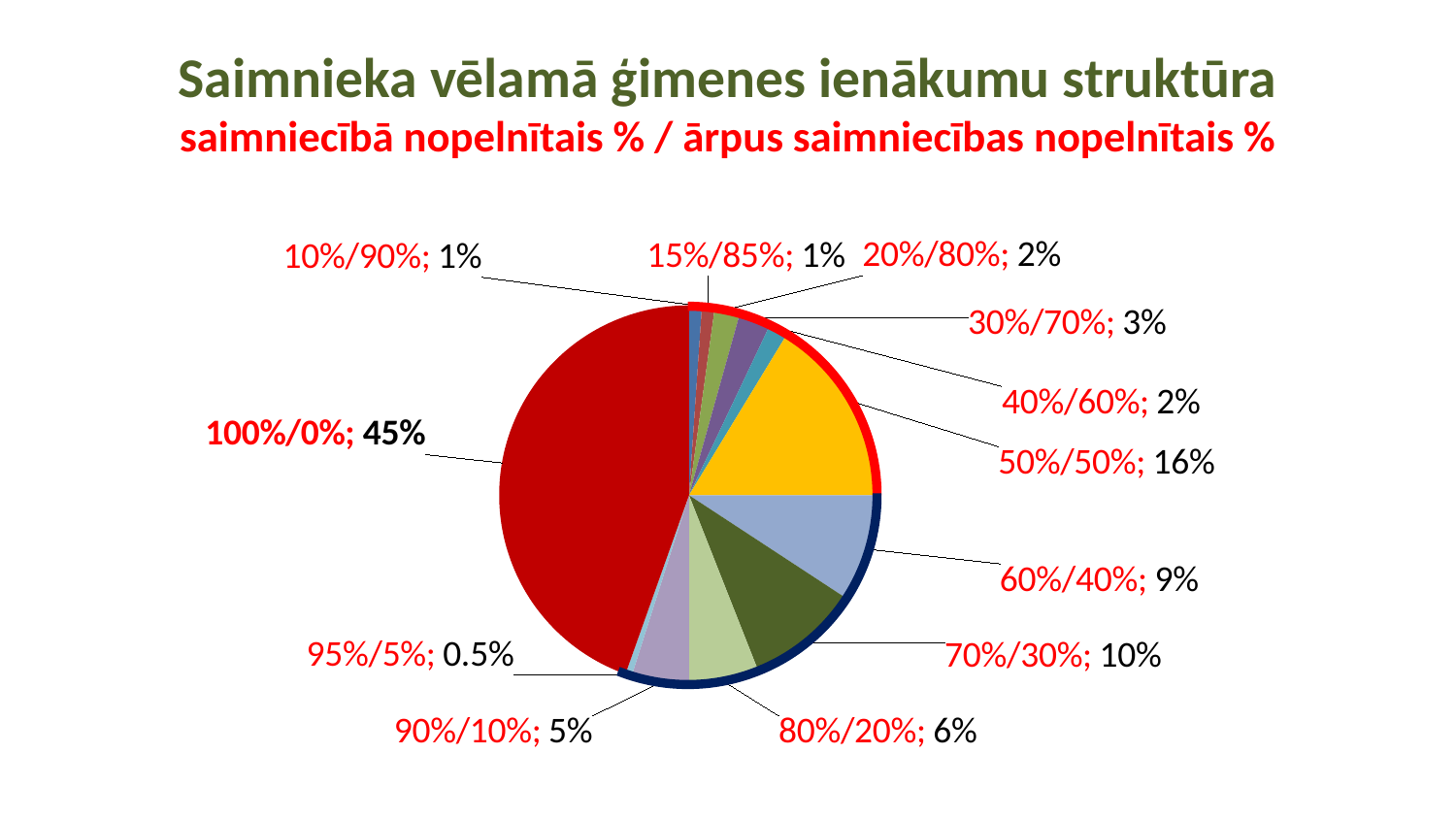
What is the value for the 70%/30% slice? 10% Which category has the smallest share of the pie? 95%/5% How many slices does the pie chart have? 12 What is the difference between the 50%/50% slice and the 60%/40% slice? 7% Which is larger, the 80%/20% slice or the 90%/10% slice? 80%/20% What is the value for the 95%/5% slice? 0.5% Which category has the largest share of the pie? 100%/0% What is the combined share of the 70%/30% and 80%/20% slices? 16% What is the value for the 50%/50% slice? 16% What type of chart is shown on the slide? pie chart What is the value for the 100%/0% slice? 45% What is the title of the chart? Saimnieka vēlamā ģimenes ienākumu struktūra